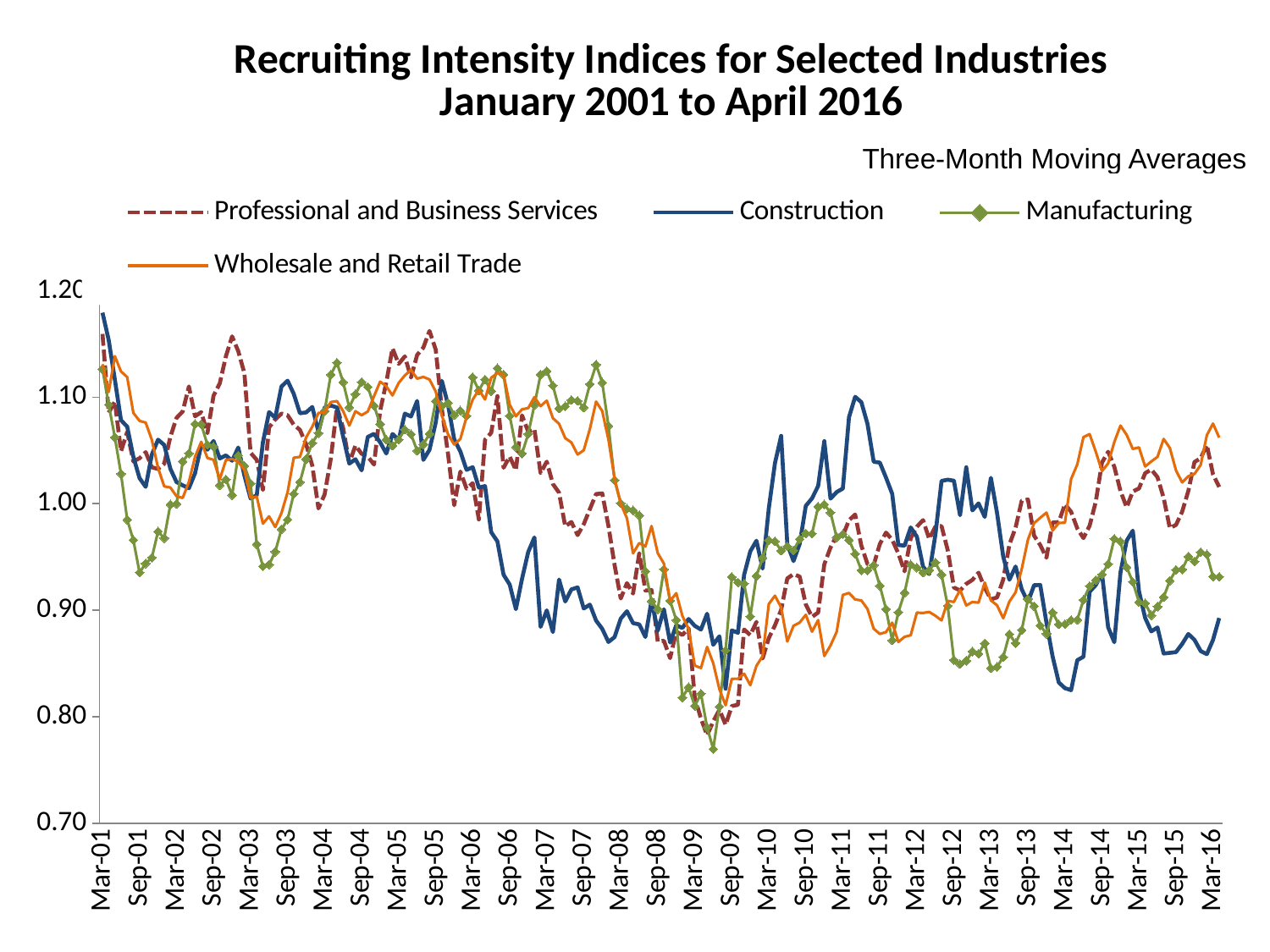
Is the value for Wholesale and Retail Trade around Sep-14 greater or less than 1.00? greater Which series has the lowest value around Mar-14? Construction Which series is drawn with a dashed line? Professional and Business Services Does the Construction series overall rise or fall from Mar-01 to Mar-16? Fall At Mar-16, which is higher: Wholesale and Retail Trade or Construction? Wholesale and Retail Trade Is the value for Construction around Mar-14 greater or less than 0.90? less What is the title of the chart? Recruiting Intensity Indices for Selected Industries January 2001 to April 2016 What kind of chart is shown on the slide? Line chart Does the Manufacturing series rise or fall from Sep-07 to Mar-09? Fall Is the value for Construction at Mar-01 greater or less than 1.10? greater How many series does the legend list? 4